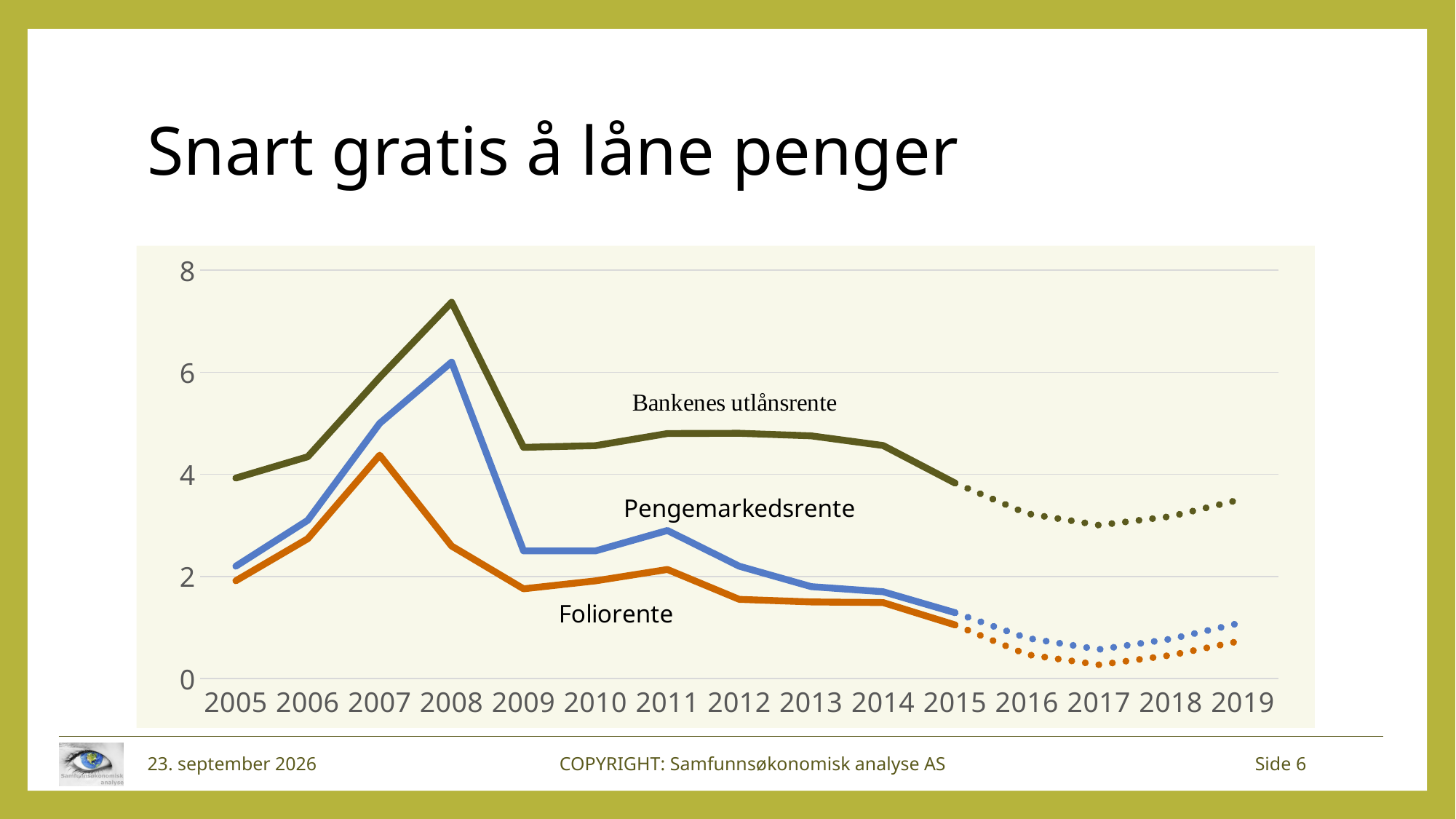
In which year does Bankenes utlånsrente reach its highest value? 2008 How many years are shown on the x axis of the chart? 15 Do the values of Bankenes utlånsrente rise or fall from 2008 to 2009? fall How many series are plotted in the chart? 3 Which series has the higher value in 2011, Bankenes utlånsrente or Foliorente? Bankenes utlånsrente In which year does Pengemarkedsrente reach its highest value? 2008 What is the title of the slide? Snart gratis å låne penger Is the value of Pengemarkedsrente in 2008 greater or less than 6? greater Is the value of Foliorente in 2009 greater or less than 2? less In which year does Foliorente reach its highest value? 2007 What kind of chart is shown on the slide? line chart Is the value of Bankenes utlånsrente in 2008 greater or less than 6? greater